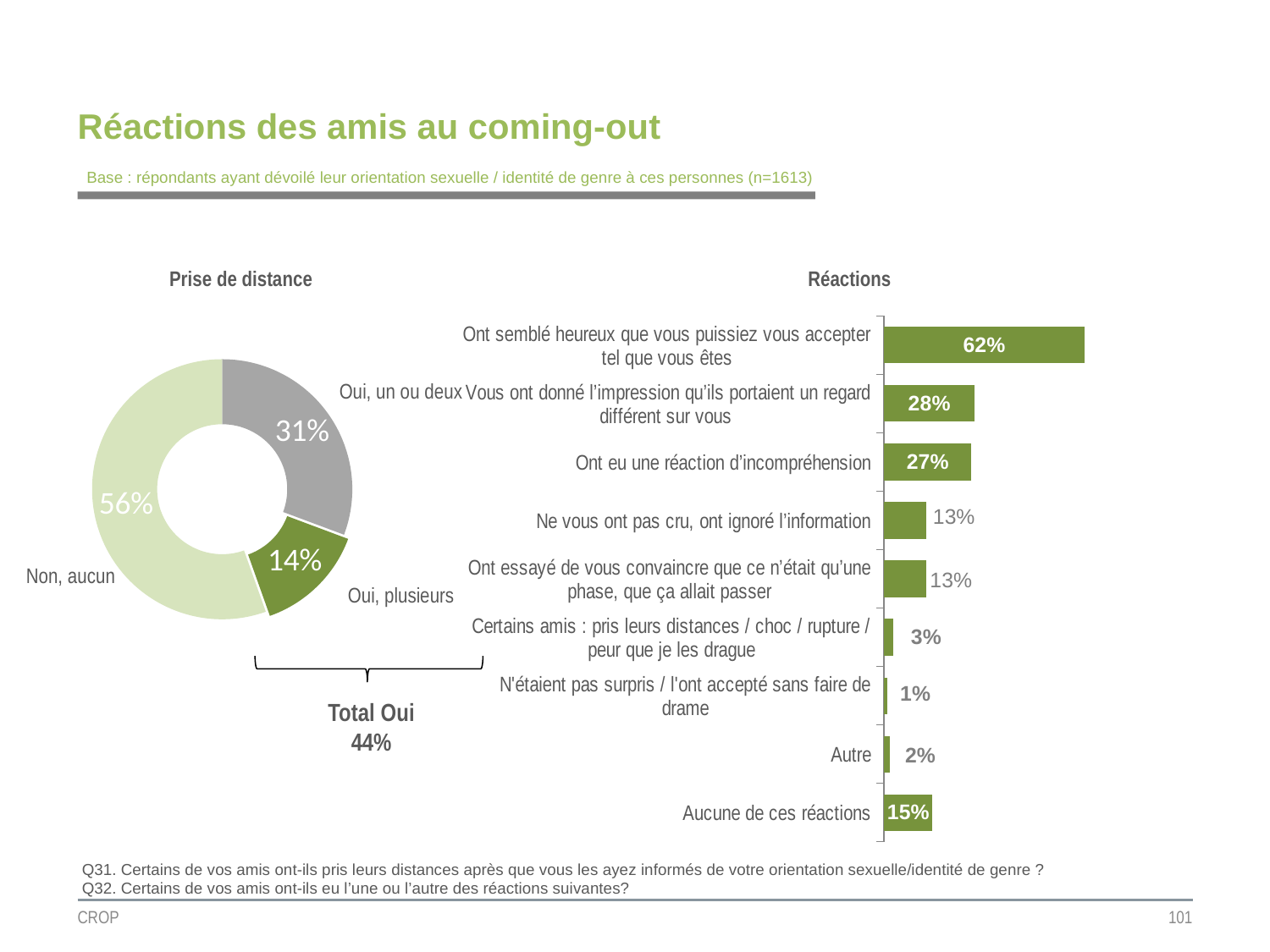
In the 'Réactions' bar chart, what is the value for 'Aucune de ces réactions'? 15% In the 'Prise de distance' donut chart, what is the difference between 'Oui, un ou deux' and 'Oui, plusieurs'? 17% In the 'Prise de distance' donut chart, what percentage answered 'Non, aucun'? 56% In the 'Réactions' bar chart, what is the difference between 'Vous ont donné l'impression qu'ils portaient un regard différent sur vous' and 'Ont eu une réaction d'incompréhension'? 1% In the 'Réactions' bar chart, which reaction has the highest value? Ont semblé heureux que vous puissiez vous accepter tel que vous êtes In the 'Réactions' bar chart, what percentage of respondents said their friends seemed happy that they could accept themselves as they are ('Ont semblé heureux que vous puissiez vous accepter tel que vous êtes')? 62% What type of chart is the 'Réactions' chart? Bar chart How many reaction categories are shown in the 'Réactions' bar chart? 9 In the 'Réactions' bar chart, which reaction has the lowest value? N'étaient pas surpris / l'ont accepté sans faire de drame In the 'Prise de distance' donut chart, what is the 'Total Oui' share shown below the chart? 44% In the 'Réactions' bar chart, which is larger: 'Aucune de ces réactions' or 'Ne vous ont pas cru, ont ignoré l'information'? Aucune de ces réactions In the 'Prise de distance' donut chart, what percentage answered 'Oui, plusieurs'? 14%